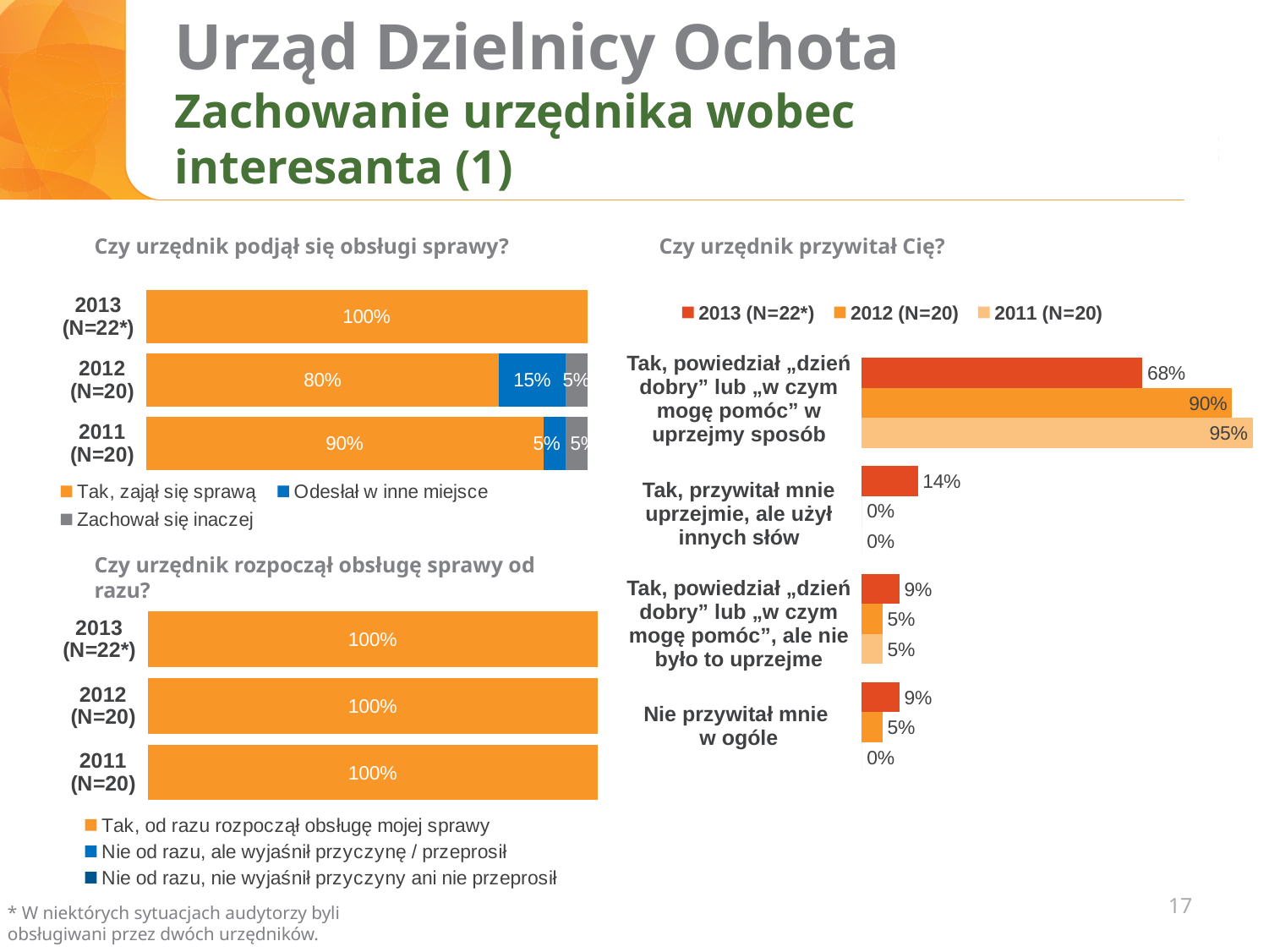
In the chart "Czy urzędnik przywitał Cię?", what is the value for 2013 (N=22*) in the category "Tak, powiedział „dzień dobry” lub „w czym mogę pomóc” w uprzejmy sposób"? 68% How many series does the legend of the chart "Czy urzędnik podjął się obsługi sprawy?" list? 3 How many categories are shown in the chart "Czy urzędnik przywitał Cię?"? 4 In the chart "Czy urzędnik przywitał Cię?", what is the difference between the 2011 (N=20) and 2013 (N=22*) values for "Tak, powiedział „dzień dobry” lub „w czym mogę pomóc” w uprzejmy sposób"? 27% In the chart "Czy urzędnik podjął się obsługi sprawy?", what is the difference between the "Tak, zajął się sprawą" values for 2011 (N=20) and 2012 (N=20)? 10% In the chart "Czy urzędnik podjął się obsługi sprawy?", what is the value for "Odesłał w inne miejsce" in 2012 (N=20)? 15% In the chart "Czy urzędnik podjął się obsługi sprawy?", which year has the highest value for "Tak, zajął się sprawą"? 2013 (N=22*) In the chart "Czy urzędnik przywitał Cię?", which is larger for "Nie przywitał mnie w ogóle": the 2013 (N=22*) value or the 2012 (N=20) value? 2013 (N=22*) In the chart "Czy urzędnik przywitał Cię?", what is the value for 2011 (N=20) in the category "Tak, powiedział „dzień dobry” lub „w czym mogę pomóc” w uprzejmy sposób"? 95% In the chart "Czy urzędnik podjął się obsługi sprawy?", what is the value for "Tak, zajął się sprawą" in 2012 (N=20)? 80% In the chart "Czy urzędnik rozpoczął obsługę sprawy od razu?", what is the value for 2011 (N=20)? 100% What type of chart is "Czy urzędnik rozpoczął obsługę sprawy od razu?"? Bar chart